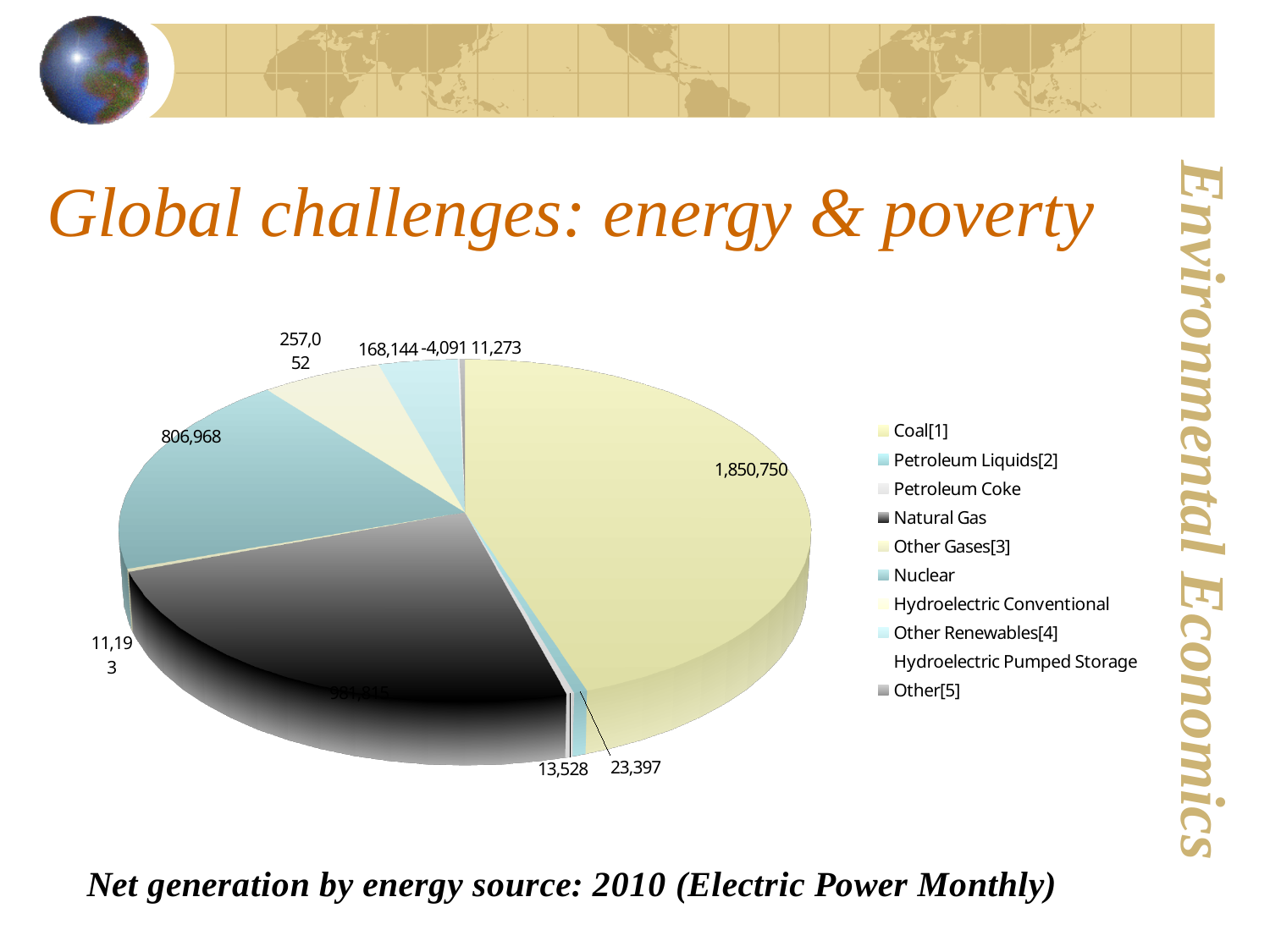
What value is shown for Hydroelectric Pumped Storage? -4,091 How many energy sources does the legend of the pie chart list? 10 What is the net generation value shown for Nuclear? 806,968 What is the difference between the values for Coal[1] and Nuclear? 1,043,782 Which energy source has the largest slice of the pie? Coal[1] Which is larger, the value for Nuclear or the value for Hydroelectric Conventional? Nuclear What value is labelled for Hydroelectric Conventional? 257,052 What value is shown for Petroleum Liquids[2]? 23,397 What kind of chart is shown on the slide? pie chart What caption is given below the pie chart? Net generation by energy source: 2010 (Electric Power Monthly) What value is labelled for Other Renewables[4]? 168,144 What is the net generation value shown for Coal[1]? 1,850,750